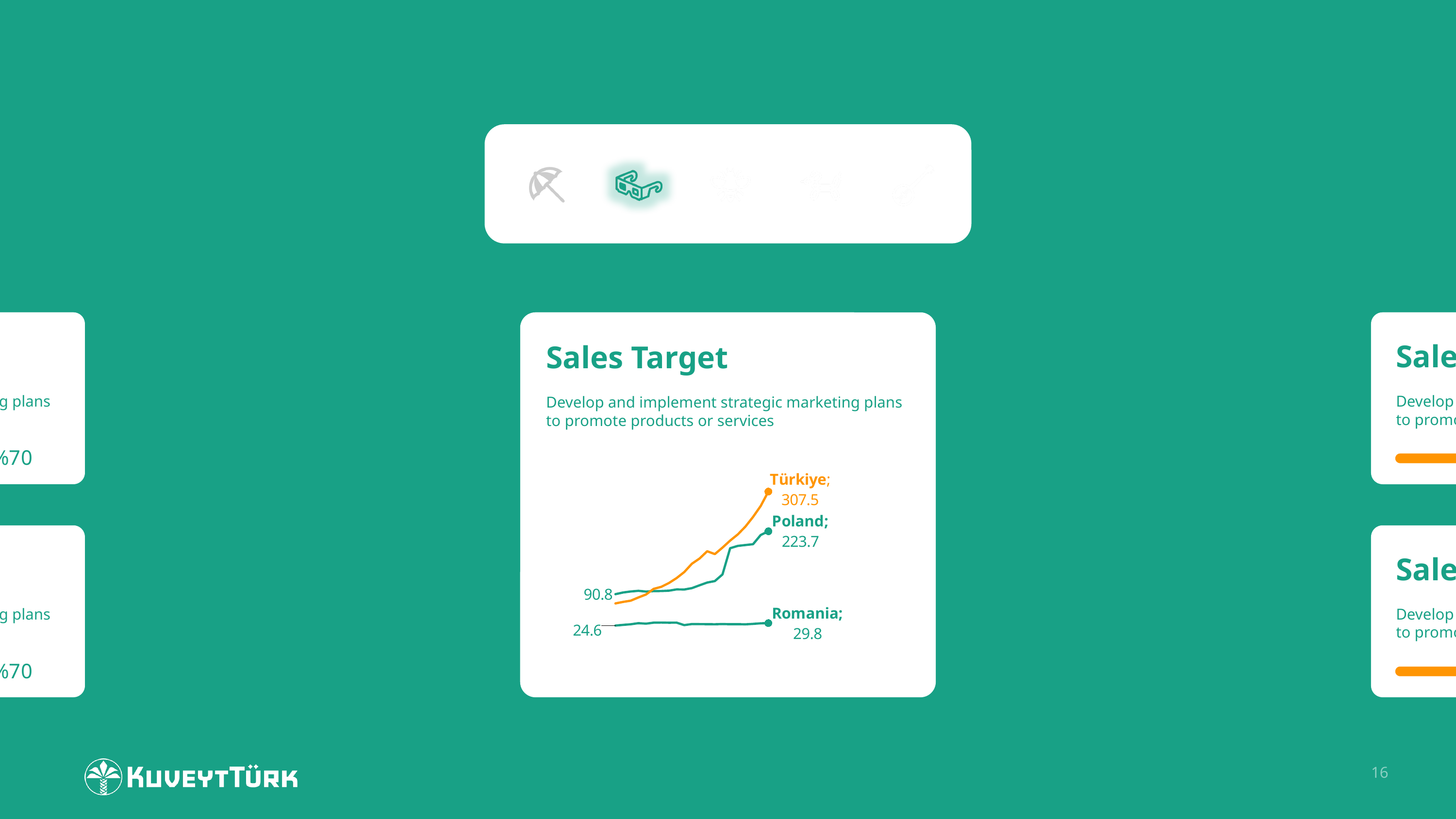
What type of chart is shown on the slide? Line chart Does the Türkiye line rise or fall from left to right? Rises What is the starting value labelled on the Romania line? 24.6 What is the final value shown for Türkiye? 307.5 Which country has the highest final value in the chart? Türkiye How many countries (series) are plotted in the chart? 3 What is the final value shown for Romania? 29.8 What is the final value shown for Poland? 223.7 Which has a larger final value, Poland or Romania? Poland What is the difference between the final values of Türkiye and Poland? 83.8 Which country has the lowest final value in the chart? Romania By how much did Romania's value increase from its labelled start (24.6) to its end (29.8)? 5.2